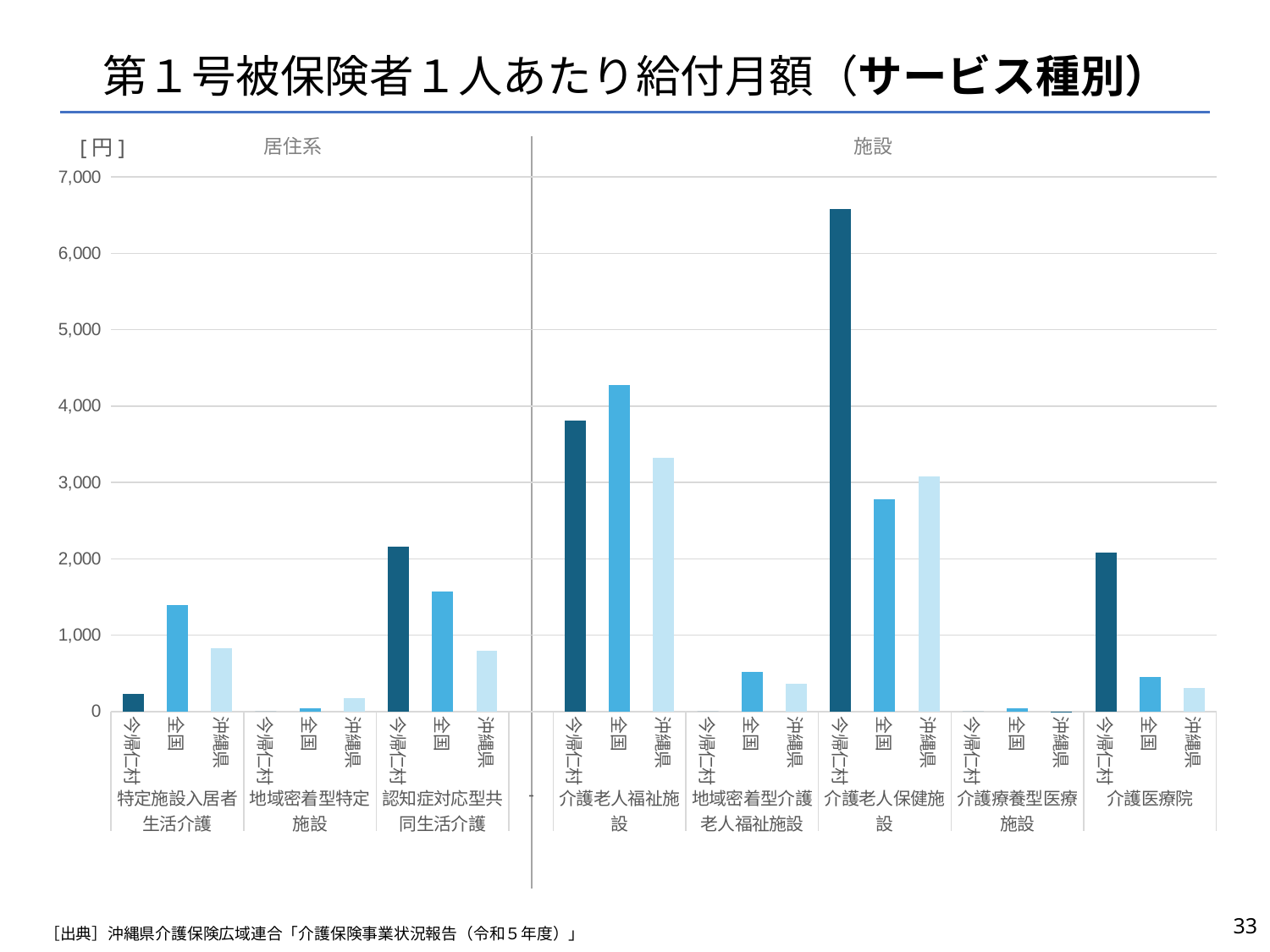
What kind of chart is shown on the slide? bar chart Within 介護老人保健施設, which of the three bars is the highest? 今帰仁村 Under 介護老人福祉施設, which is larger: 今帰仁村 or 全国? 全国 Under 介護老人保健施設, which is larger: 全国 or 沖縄県? 沖縄県 Which service type contains the tallest bar on the chart? 介護老人保健施設 What unit is indicated for the y axis of the chart? 円 How many service types are shown along the x axis of the chart? 8 Within 特定施設入居者生活介護, which of the three bars is the lowest? 今帰仁村 Under 認知症対応型共同生活介護, which is larger: 今帰仁村 or 全国? 今帰仁村 Is the value for 今帰仁村 under 介護医療院 greater or less than 1,000? greater Is the value for 全国 under 介護老人福祉施設 greater or less than 4,000? greater Is the value for 今帰仁村 under 介護老人保健施設 greater or less than 6,000? greater